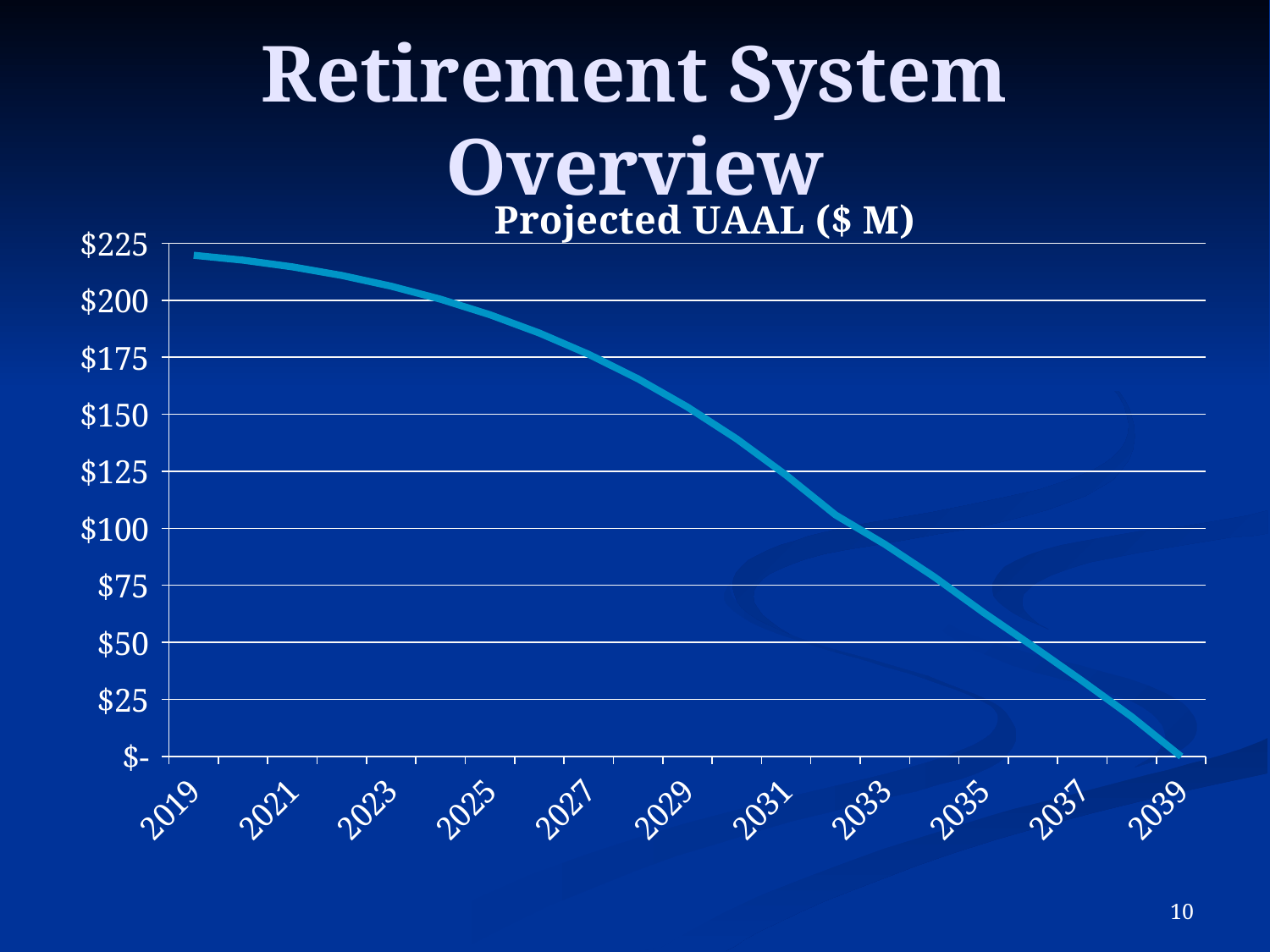
Which year has the lowest projected UAAL? 2039 Is the value for 2019 greater or less than $200? greater Do the values rise or fall from 2019 to 2039? fall Is the value for 2031 greater or less than $100? greater What kind of chart is shown on the slide? line chart Which year has the highest projected UAAL? 2019 Is the value for 2035 greater or less than $50? greater How many year labels are shown on the x axis? 11 What is the title of the chart? Projected UAAL ($ M) Which is larger, the value for 2021 or the value for 2035? 2021